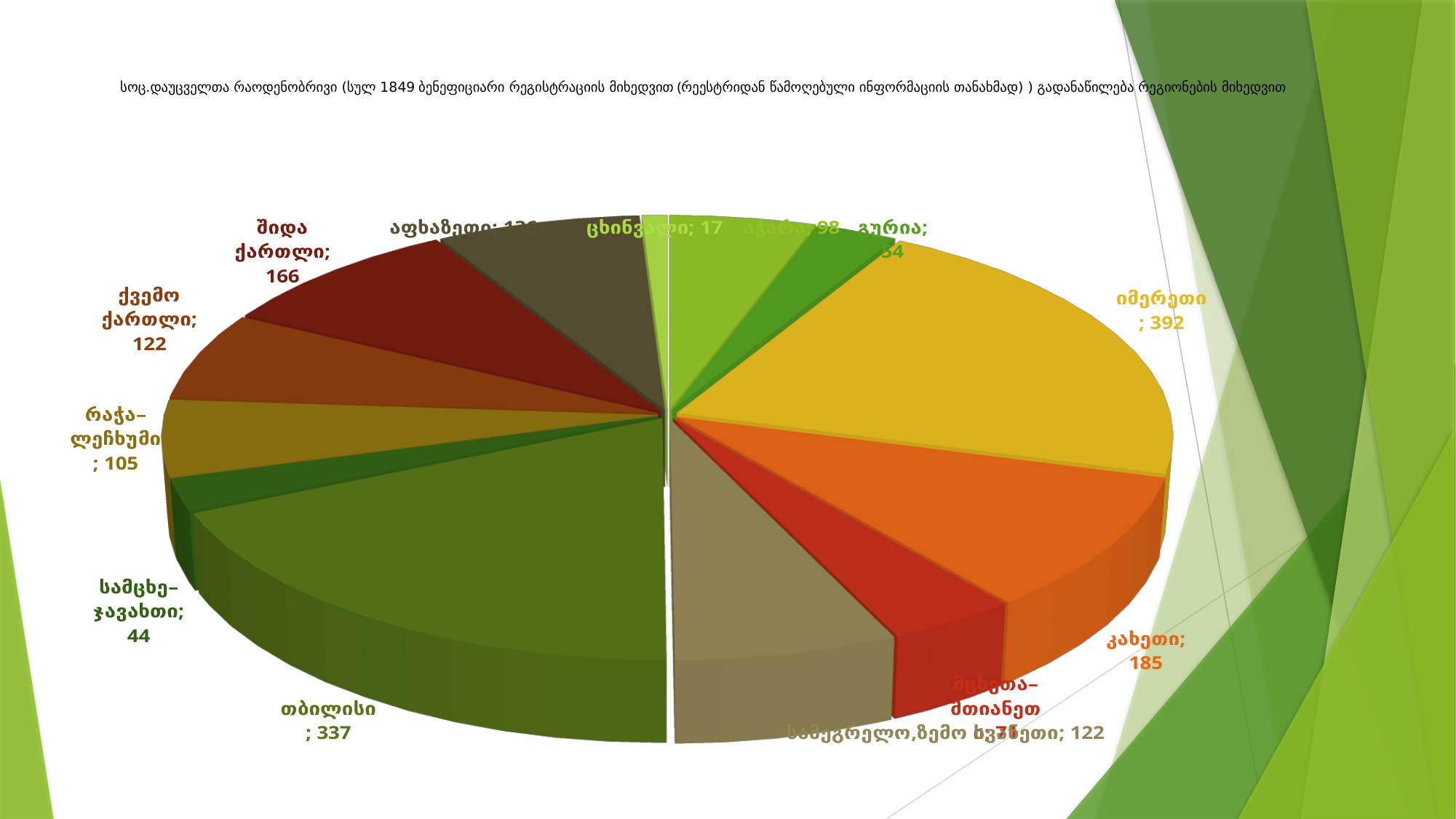
What kind of chart is shown on the slide? pie chart What is the value for გურია? 54 What is the value for შიდა ქართლი? 166 Which region has the largest slice of the pie? იმერეთი What is the value for თბილისი? 337 Which is larger, the value for კახეთი or the value for შიდა ქართლი? კახეთი Which region has the smallest slice of the pie? ცხინვალი What is the difference between the values for იმერეთი and თბილისი? 55 What is the value for რაჭა-ლეჩხუმი? 105 What is the value for კახეთი? 185 What is the value for სამცხე-ჯავახეთი? 44 What is the value for იმერეთი? 392